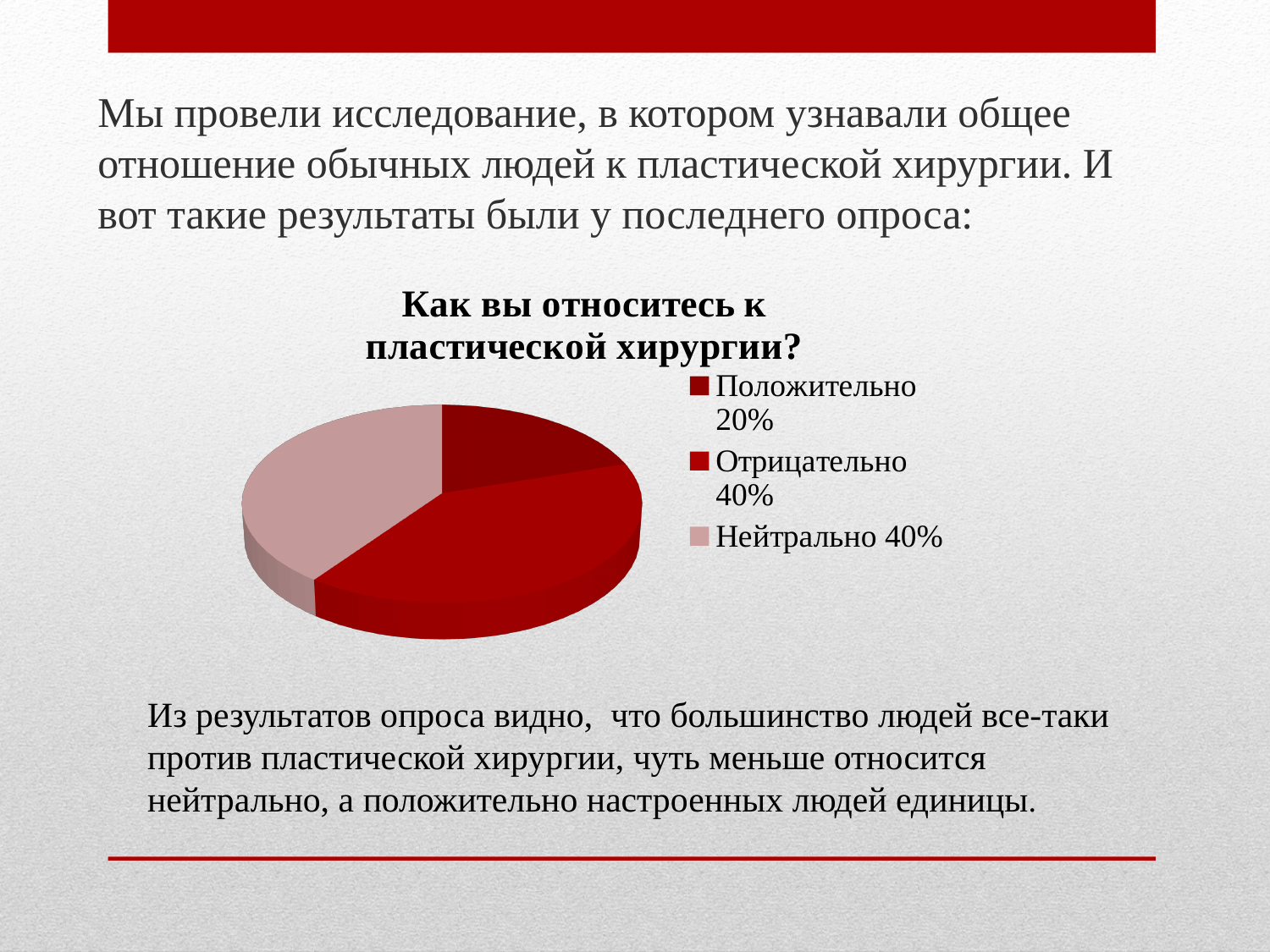
What percentage of respondents answered "Отрицательно"? 40% Which slice is shown in the lightest (pink) colour? Нейтрально What is the title of the chart? Как вы относитесь к пластической хирургии? How many categories does the pie chart show? 3 What percentage of respondents answered "Нейтрально"? 40% What percentage of respondents answered "Положительно"? 20% Which is larger: the share for "Положительно" or the share for "Отрицательно"? Отрицательно What share of the pie do "Отрицательно" and "Нейтрально" make up together? 80% What is the difference between the "Отрицательно" share and the "Положительно" share? 20% Which category has the smallest share of the pie? Положительно What kind of chart is shown on the slide? Pie chart How many entries does the legend list? 3